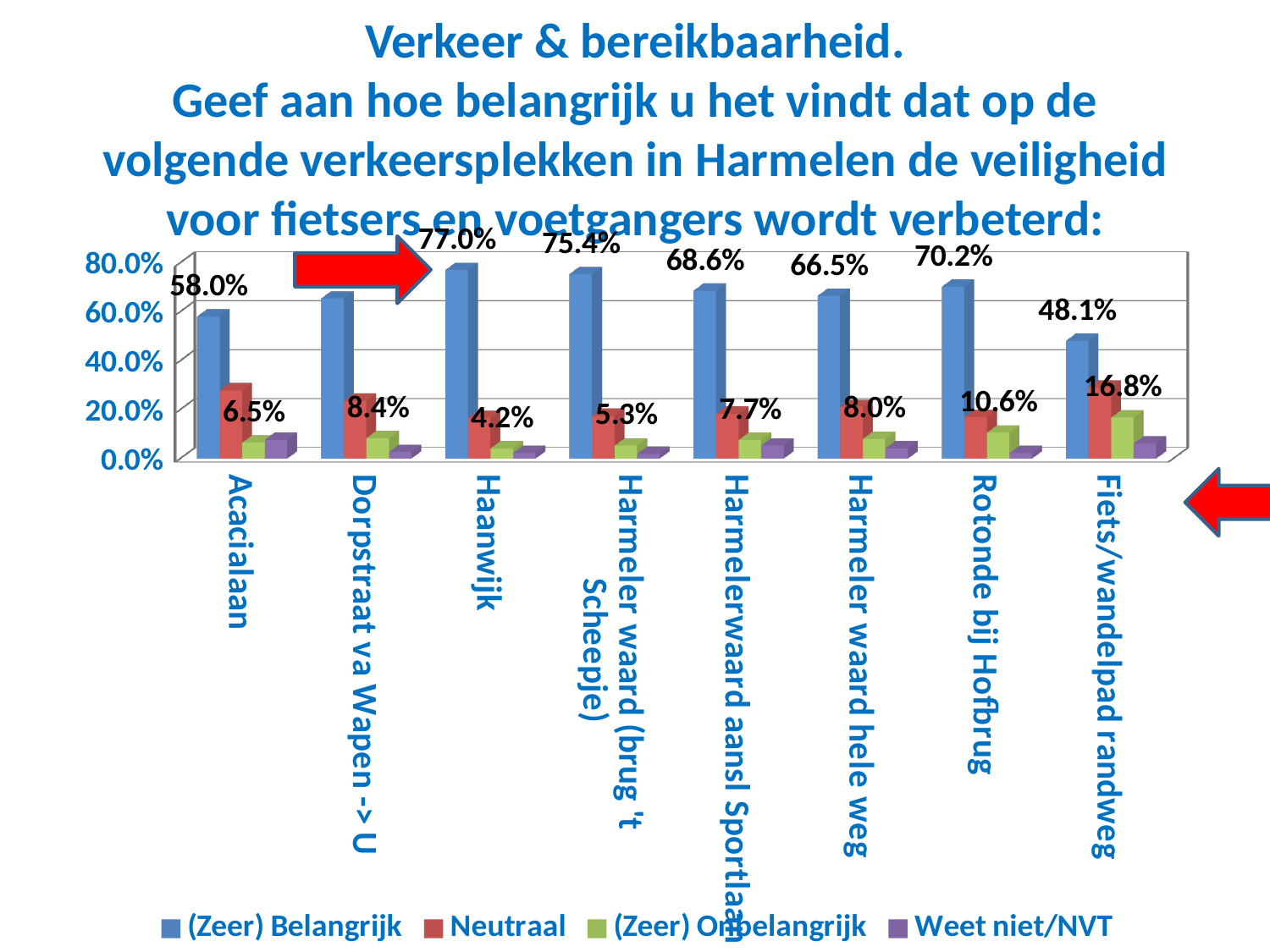
What is the difference between the (Zeer) Belangrijk values for Haanwijk and Acacialaan? 19.0 percentage points Which location has the highest (Zeer) Belangrijk value? Haanwijk How many series does the legend list? 4 What is the (Zeer) Onbelangrijk value for Rotonde bij Hofbrug? 10.6% Which location has the highest (Zeer) Onbelangrijk value? Fiets/wandelpad randweg Which location has the lowest (Zeer) Belangrijk value? Fiets/wandelpad randweg What is the (Zeer) Onbelangrijk value for Fiets/wandelpad randweg? 16.8% Which has the larger (Zeer) Belangrijk value: Harmelerwaard aansl Sportlaan or Harmeler waard hele weg? Harmelerwaard aansl Sportlaan Is the (Zeer) Belangrijk value for Dorpstraat va Wapen -> U greater or less than 60.0%? greater What kind of chart is shown on the slide? bar chart What is the (Zeer) Belangrijk value for Haanwijk? 77.0% How many traffic locations (categories) are shown on the x axis? 8